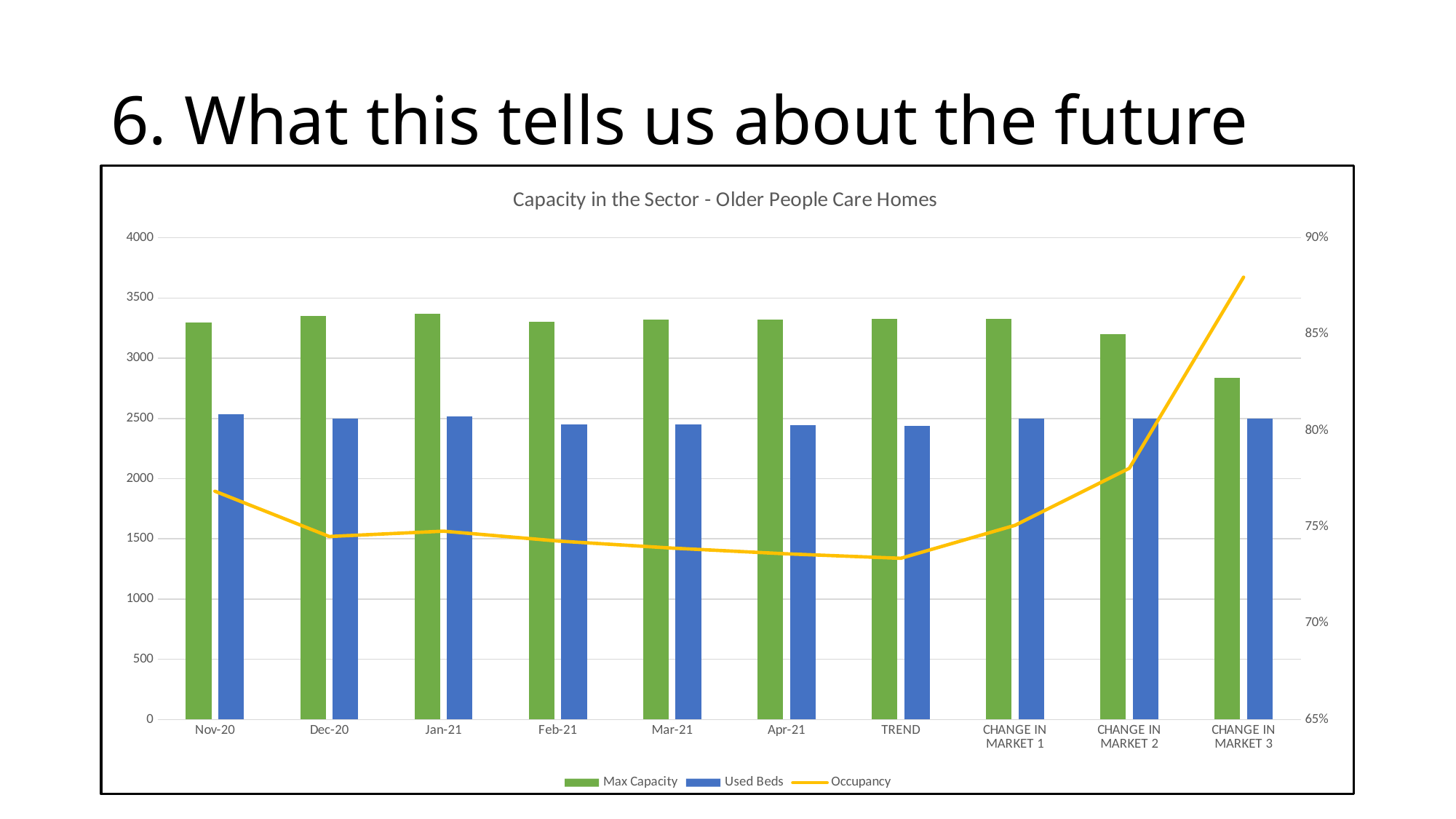
Does the Occupancy line rise or fall from Nov-20 to TREND? fall Which is larger for Nov-20, Max Capacity or Used Beds? Max Capacity What kind of chart is this? Combined bar and line chart Which category has the highest Occupancy? CHANGE IN MARKET 3 How many categories are shown on the x axis? 10 Is the Occupancy value for CHANGE IN MARKET 3 greater or less than 85%? greater How many series does the legend list? 3 Which series is plotted as a line rather than bars? Occupancy What is the title of the chart? Capacity in the Sector - Older People Care Homes Is the Max Capacity value for CHANGE IN MARKET 3 greater or less than 3000? less Is the Max Capacity value for Nov-20 greater or less than 3000? greater Which category has the lowest Max Capacity? CHANGE IN MARKET 3